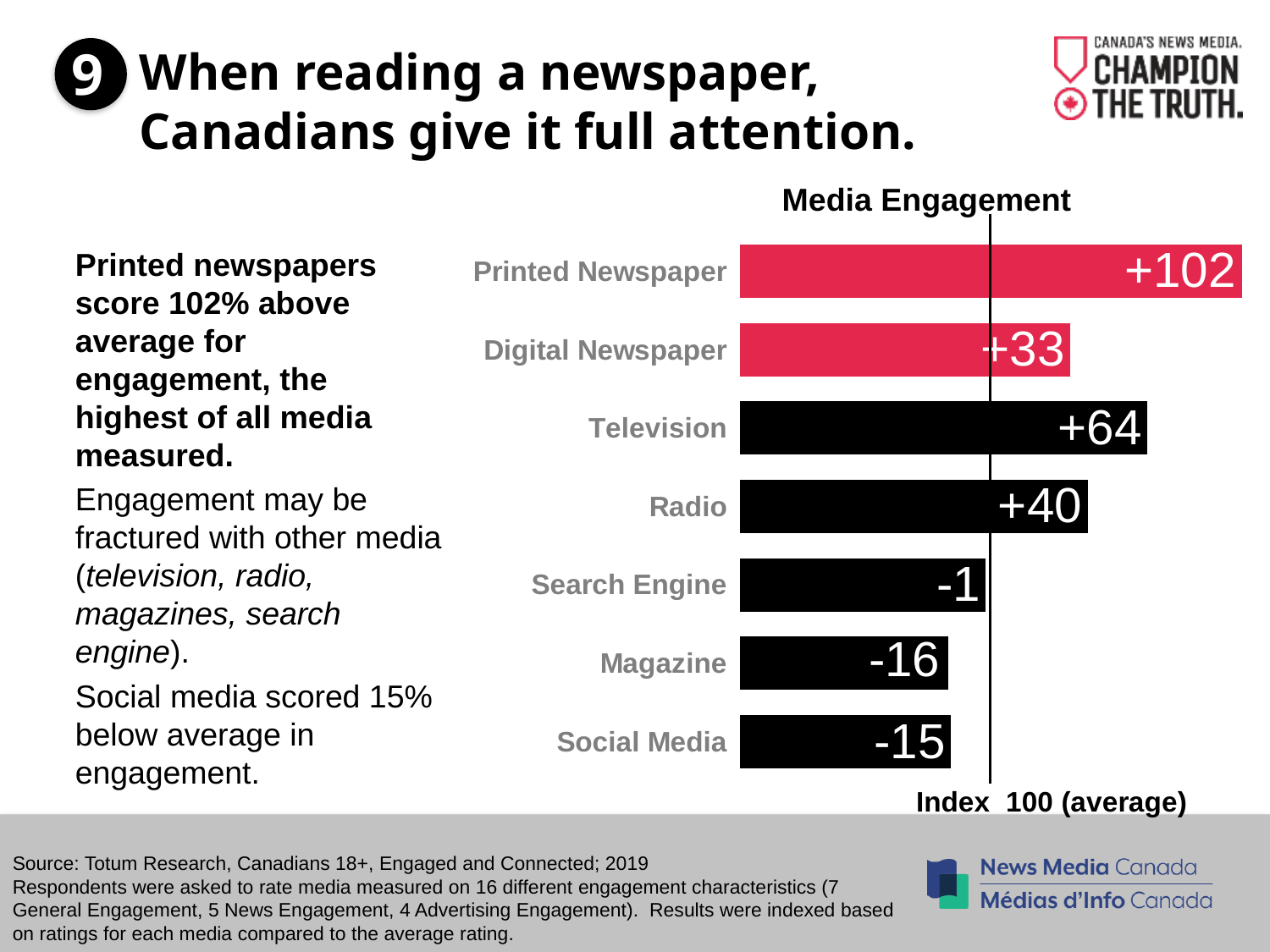
What is the value for Printed Newspaper in the Media Engagement chart? +102 What is the value for Television in the Media Engagement chart? +64 Which has a larger value in the Media Engagement chart, Television or Radio? Television How many categories are shown in the Media Engagement chart? 7 Which category has the highest value in the Media Engagement chart? Printed Newspaper What is the difference between the values for Printed Newspaper and Television in the Media Engagement chart? 38 What kind of chart is the Media Engagement chart? Bar chart What is the title of the chart on the slide? Media Engagement Which category has the lowest value in the Media Engagement chart? Magazine What is the value for Search Engine in the Media Engagement chart? -1 What is the difference between the values for Radio and Digital Newspaper in the Media Engagement chart? 7 What is the value for Magazine in the Media Engagement chart? -16